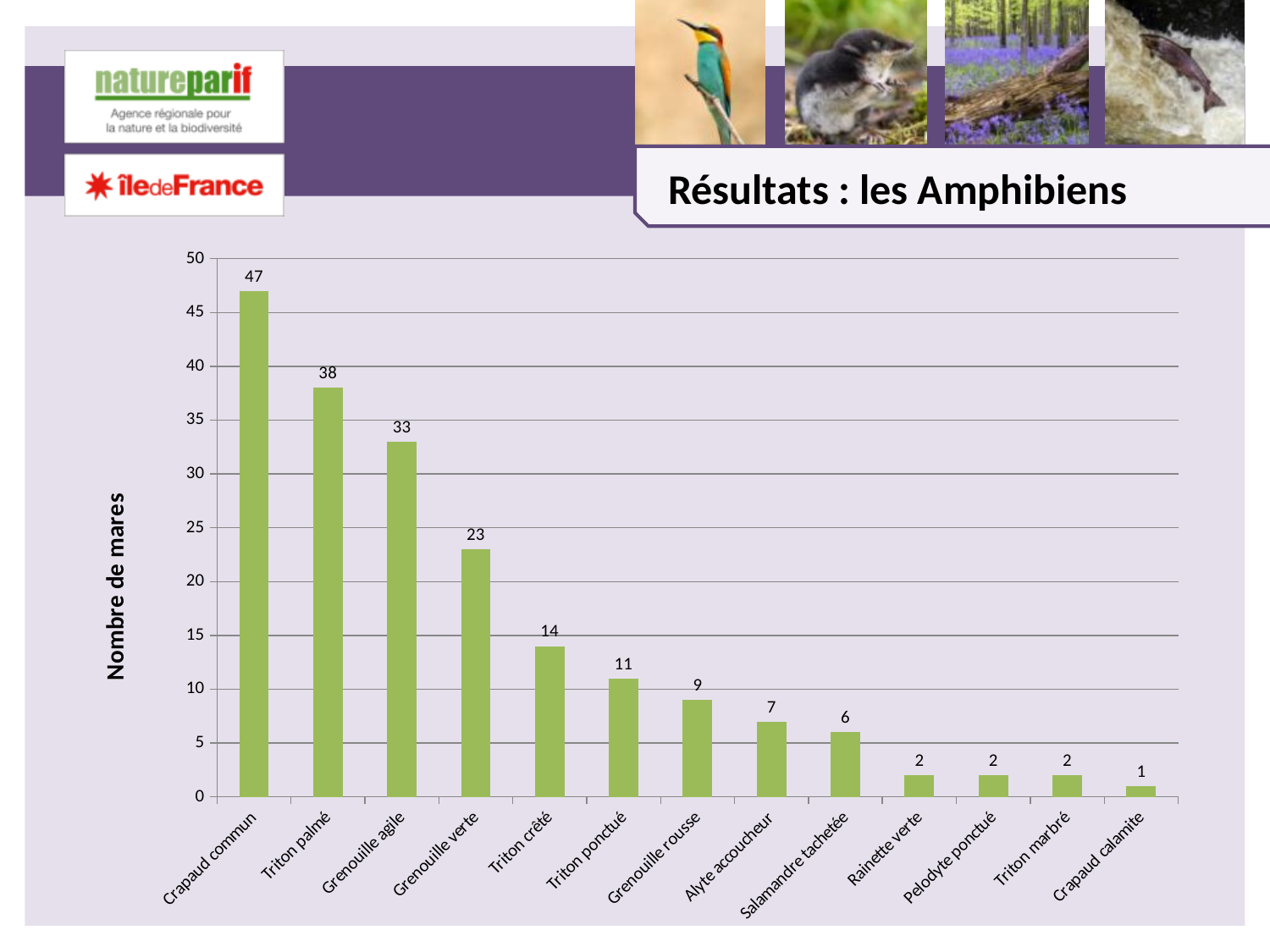
What kind of chart is shown on the slide? bar chart Which species has the lowest number of mares? Crapaud calamite Do the values rise or fall from left to right along the x axis? fall What is the number of mares for Crapaud commun? 47 What is the difference in number of mares between Crapaud commun and Triton crêté? 33 What is the number of mares for Grenouille verte? 23 Which has more mares, Triton ponctué or Grenouille rousse? Triton ponctué What is the number of mares for Salamandre tachetée? 6 Which species has the highest number of mares? Crapaud commun How many species are shown on the x axis of the chart? 13 Is the value for Grenouille agile greater or less than 30? greater What is the difference in number of mares between Triton palmé and Grenouille agile? 5